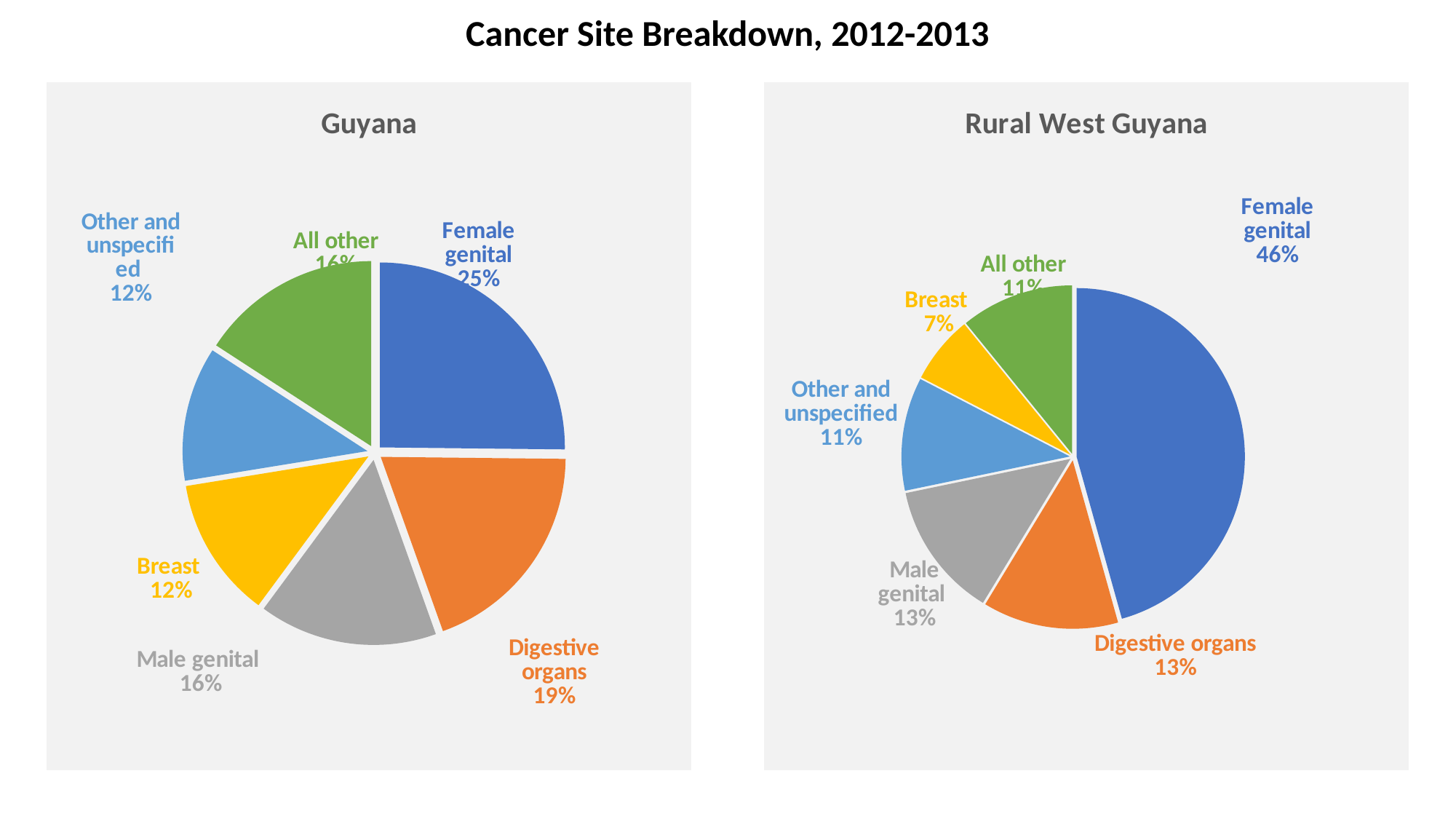
In the Rural West Guyana chart, which cancer site has the smallest share? Breast Which chart shows a larger share for Female genital, Guyana or Rural West Guyana? Rural West Guyana In the Guyana chart, what is the share for Digestive organs? 19% In the Rural West Guyana chart, what is the share for Breast? 7% What is the overall title of the slide? Cancer Site Breakdown, 2012-2013 In the Rural West Guyana chart, what share of cancer sites is Female genital? 46% In the Guyana chart, what is the difference between the Female genital share and the Breast share? 13% What type of chart is used for the Guyana breakdown? Pie chart In the Guyana chart, what share of cancer sites is Female genital? 25% In the Guyana chart, which is larger, the share for Male genital or the share for Breast? Male genital In the Guyana chart, which cancer site has the largest share? Female genital How many slices does the Rural West Guyana pie chart have? 6